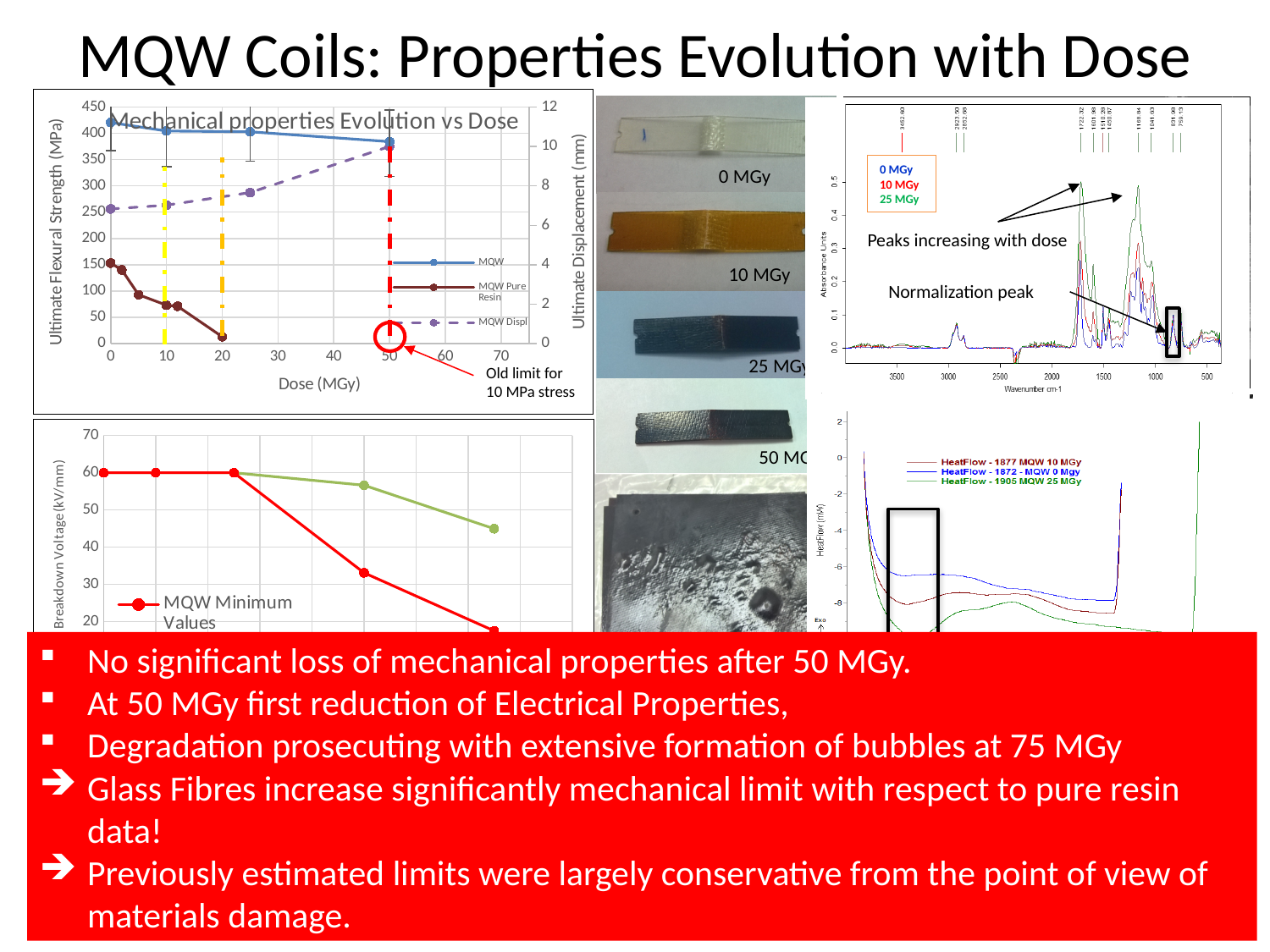
In the 'Mechanical properties Evolution vs Dose' chart, does the MQW Displ series rise or fall as dose increases? rise How many series does the legend of the 'Mechanical properties Evolution vs Dose' chart list? 3 In the bottom-left breakdown voltage chart, is the MQW Minimum Values point at 0 MGy greater or less than 50 kV/mm? greater In the 'Mechanical properties Evolution vs Dose' chart, does the MQW Pure Resin series rise or fall as dose increases? fall In the 'Mechanical properties Evolution vs Dose' chart, at 10 MGy which series has the higher flexural strength, MQW or MQW Pure Resin? MQW What is the y-axis label of the bottom-left chart? Breakdown Voltage (kV/mm) In the 'Mechanical properties Evolution vs Dose' chart, is the MQW Pure Resin flexural strength at 20 MGy greater or less than 50 MPa? less In the bottom-left breakdown voltage chart, does the MQW Minimum Values series rise or fall as dose increases? fall What kind of chart is the 'Mechanical properties Evolution vs Dose' chart at the top left? line chart In the 'Mechanical properties Evolution vs Dose' chart, what are the three legend entries? MQW, MQW Pure Resin, MQW Displ In the 'Mechanical properties Evolution vs Dose' chart, is the MQW flexural strength at 50 MGy greater or less than 300 MPa? greater How many HeatFlow series does the legend of the heat flow chart at the bottom right list? 3